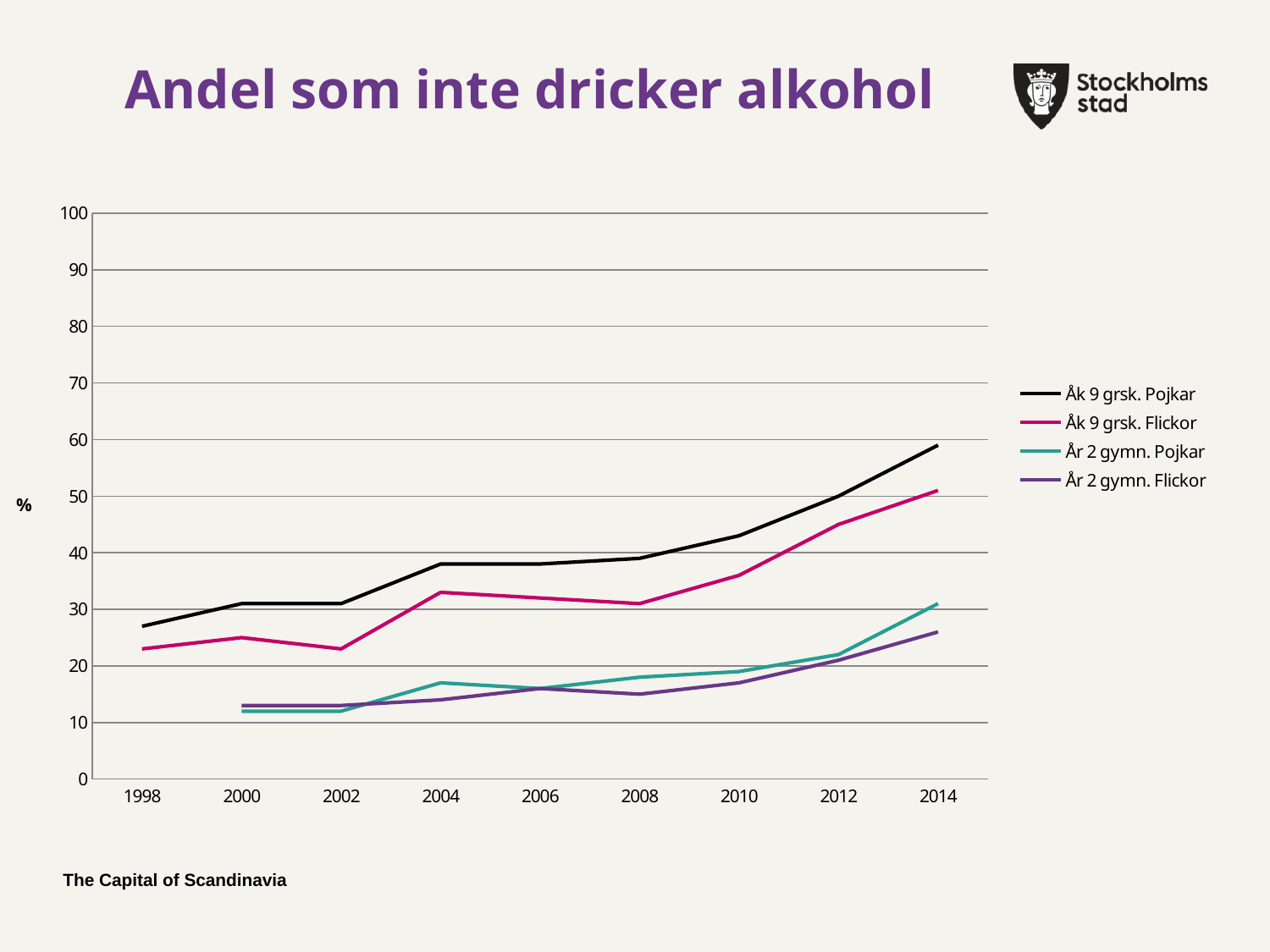
Is the value for År 2 gymn. Flickor in 2000 greater or less than 20? less Is the value for Åk 9 grsk. Pojkar in 2014 greater or less than 50? greater Does the Åk 9 grsk. Pojkar line generally rise or fall from 1998 to 2014? rise What is the title of the chart? Andel som inte dricker alkohol Is the value for År 2 gymn. Pojkar in 2014 greater or less than 20? greater What kind of chart is shown on the slide? line chart How many years are labelled on the x axis? 9 How many series does the legend list? 4 In 2014, which is larger: Åk 9 grsk. Flickor or År 2 gymn. Pojkar? Åk 9 grsk. Flickor Which series has the lowest value in 2014? År 2 gymn. Flickor Which series has the highest value in 2014? Åk 9 grsk. Pojkar